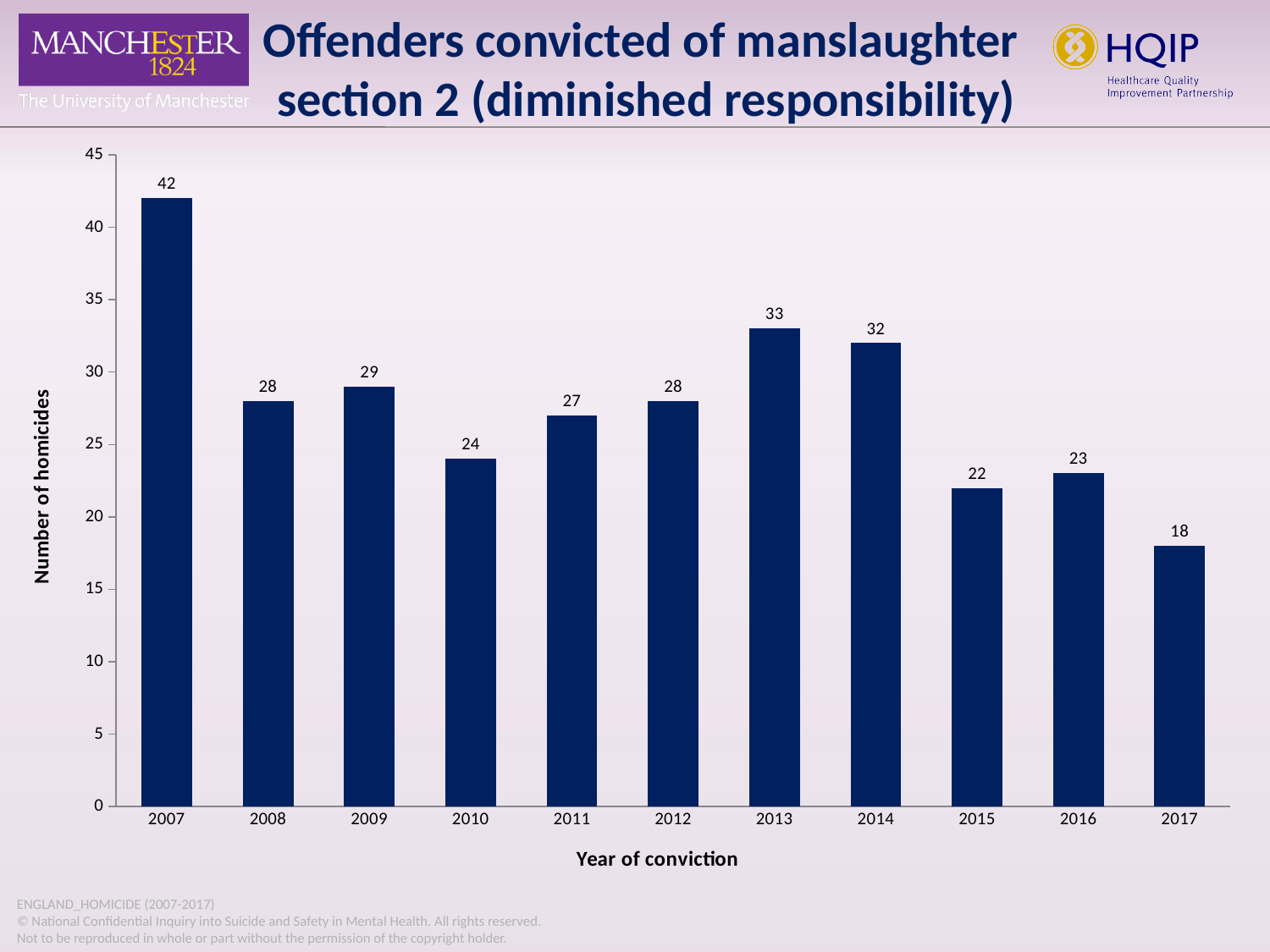
How many years of conviction are shown on the x axis? 11 What is the label of the y axis? Number of homicides What is the number of homicides for 2017? 18 What is the number of homicides for 2007? 42 Which year has more homicides, 2010 or 2011? 2011 What kind of chart is shown on the slide? Bar chart What is the difference between the number of homicides in 2013 and 2014? 1 Which year of conviction has the lowest number of homicides? 2017 What is the number of homicides for 2013? 33 What is the difference between the number of homicides in 2007 and 2017? 24 Which year of conviction has the highest number of homicides? 2007 Is the value for 2014 greater or less than 30? greater